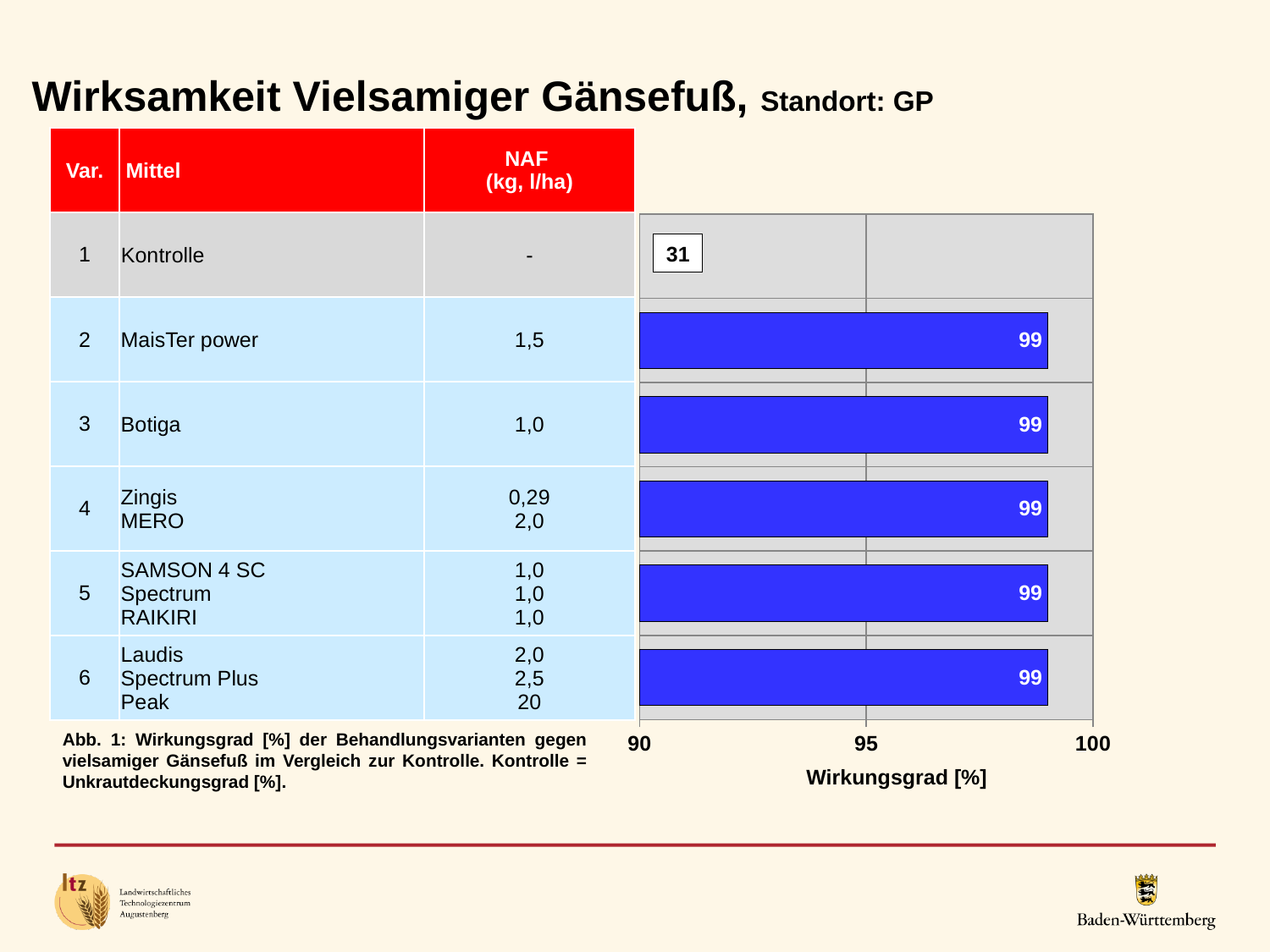
What are the minimum and maximum values shown on the horizontal axis of the chart? 90 and 100 What is the Wirkungsgrad [%] value shown for Botiga (Var. 3)? 99 How many treatment variants (excluding the Kontrolle) have bars plotted in the chart? 5 What is the Wirkungsgrad [%] value shown for MaisTer power (Var. 2)? 99 What is the Wirkungsgrad [%] value for Var. 5 (SAMSON 4 SC / Spectrum / RAIKIRI)? 99 Do the Wirkungsgrad values change from Var. 2 to Var. 6, or do they stay the same? stay the same What is the Wirkungsgrad [%] value for Var. 6 (Laudis / Spectrum Plus / Peak)? 99 Is the Wirkungsgrad value for Botiga (Var. 3) greater or less than 95? greater What is the label of the horizontal axis of the chart? Wirkungsgrad [%] What is the difference between the Wirkungsgrad values of Var. 2 (MaisTer power) and Var. 4 (Zingis / MERO)? 0 What value is shown for the Kontrolle (Var. 1) in the chart? 31 What kind of chart is shown on the slide? bar chart